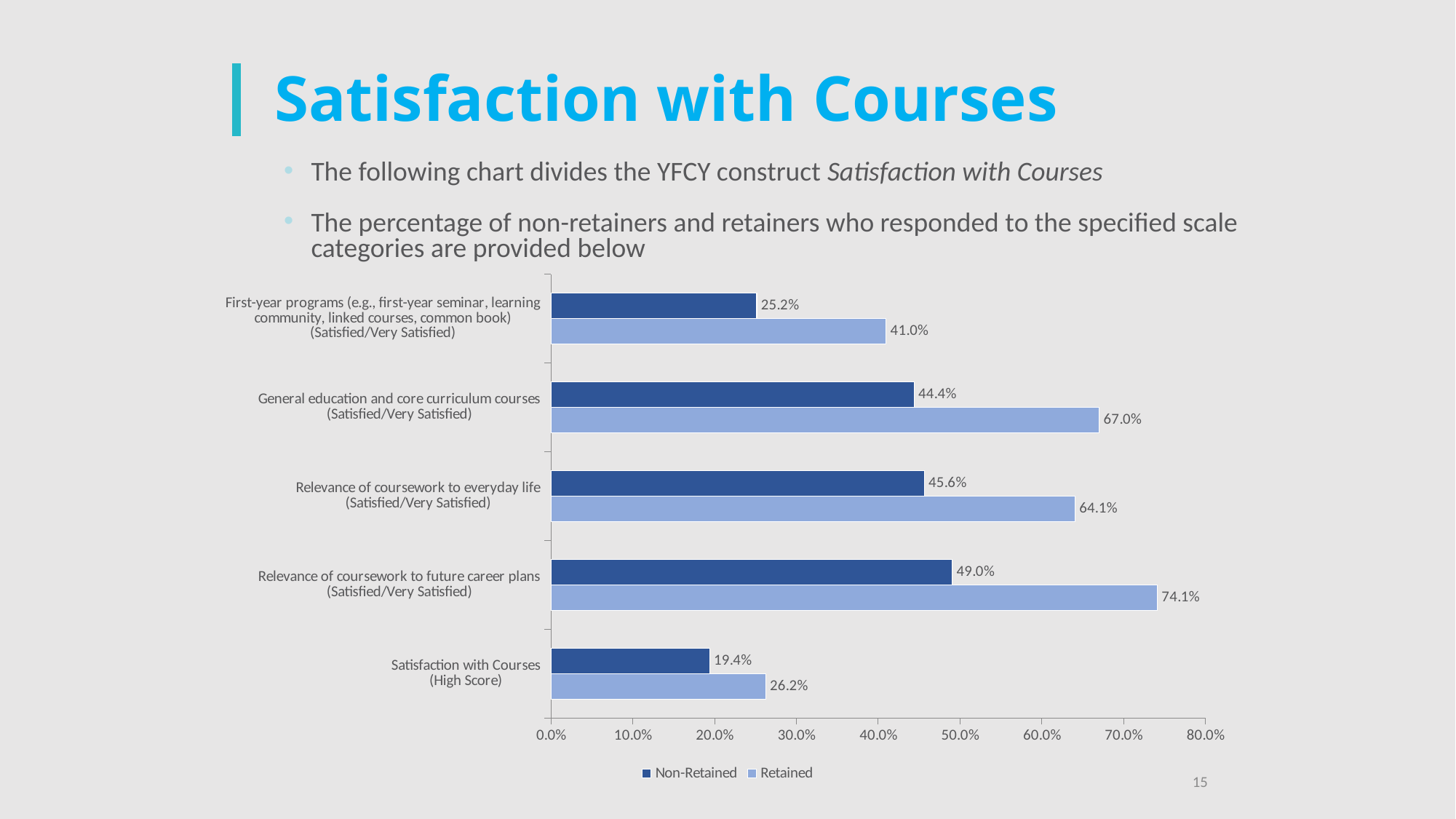
What kind of chart is shown on the slide? Bar chart Is the Retained value for General education and core curriculum courses greater or less than 60.0%? greater What is the Retained value for Relevance of coursework to future career plans (Satisfied/Very Satisfied)? 74.1% What is the Retained value for Satisfaction with Courses (High Score)? 26.2% What are the two series named in the legend? Non-Retained and Retained What is the Non-Retained value for First-year programs (Satisfied/Very Satisfied)? 25.2% What is the difference between the Retained and Non-Retained values for General education and core curriculum courses (Satisfied/Very Satisfied)? 22.6% Which is larger for Relevance of coursework to everyday life: the Retained value or the Non-Retained value? Retained Which category has the lowest Non-Retained value? Satisfaction with Courses (High Score) How many series does the legend list? 2 How many categories are shown on the chart? 5 Which category has the highest Retained value? Relevance of coursework to future career plans (Satisfied/Very Satisfied)